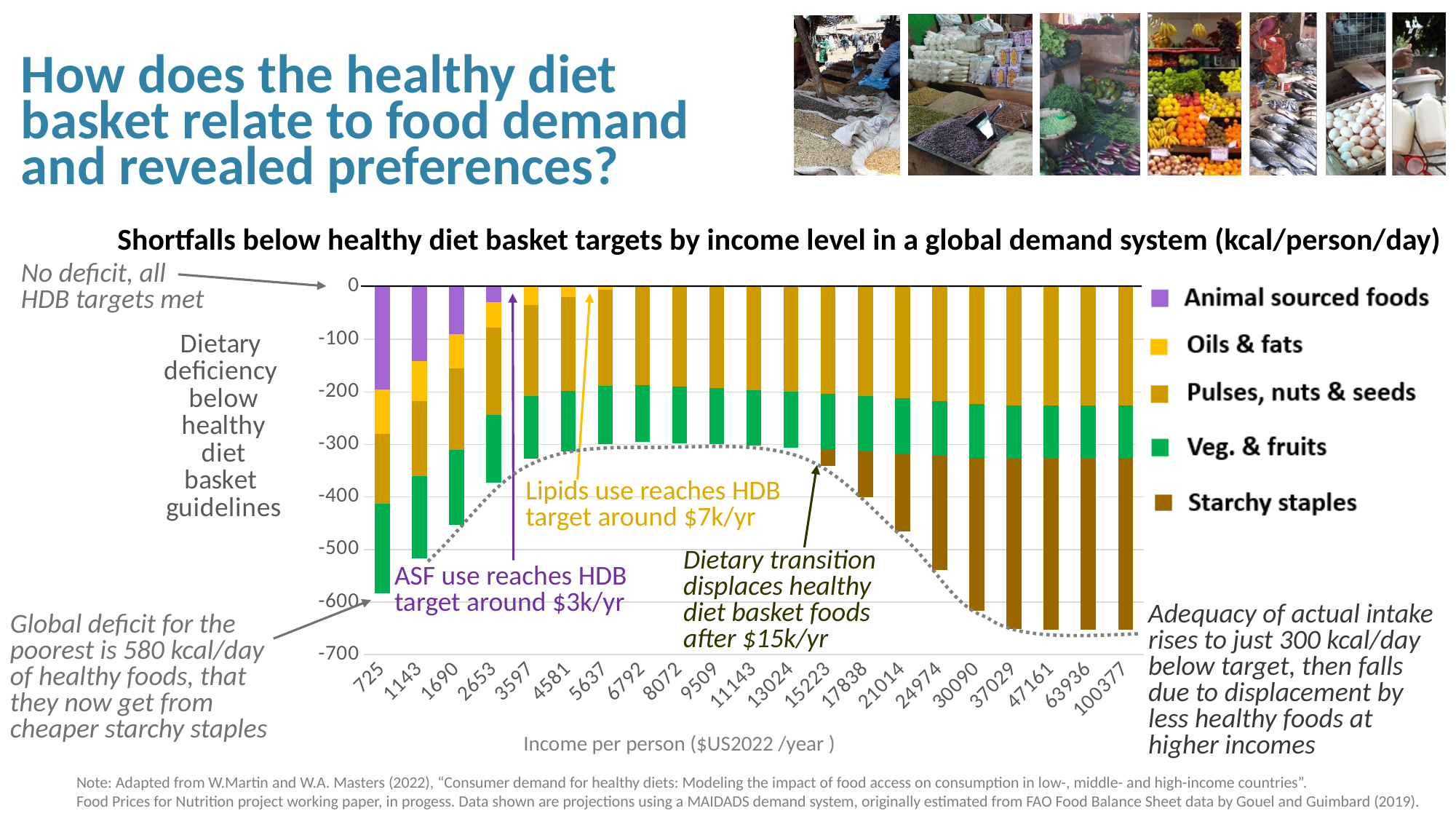
How many income-level categories are shown along the x axis of the chart? 21 How many series does the chart's legend list? 5 Is the bottom of the stacked bar for income level 100377 greater or less than -600 on the y axis? less What is the x-axis label of the chart? Income per person ($US2022 /year ) What is the title of the chart? Shortfalls below healthy diet basket targets by income level in a global demand system (kcal/person/day) Which has the larger total shortfall, the bar for income level 725 or the bar for income level 9509? 725 What kind of chart is shown on the slide? Stacked bar chart Is the bottom of the stacked bar for income level 9509 greater or less than -400 on the y axis? greater Moving from income level 725 to 9509, does the total shortfall shrink or grow? Shrinks Which series appears only in the bars for the lowest income levels (725 to 3597)? Animal sourced foods Moving from income level 15223 to 100377, does the Starchy staples segment grow or shrink? Grows Is the bottom of the stacked bar for income level 725 greater or less than -500 on the y axis? less